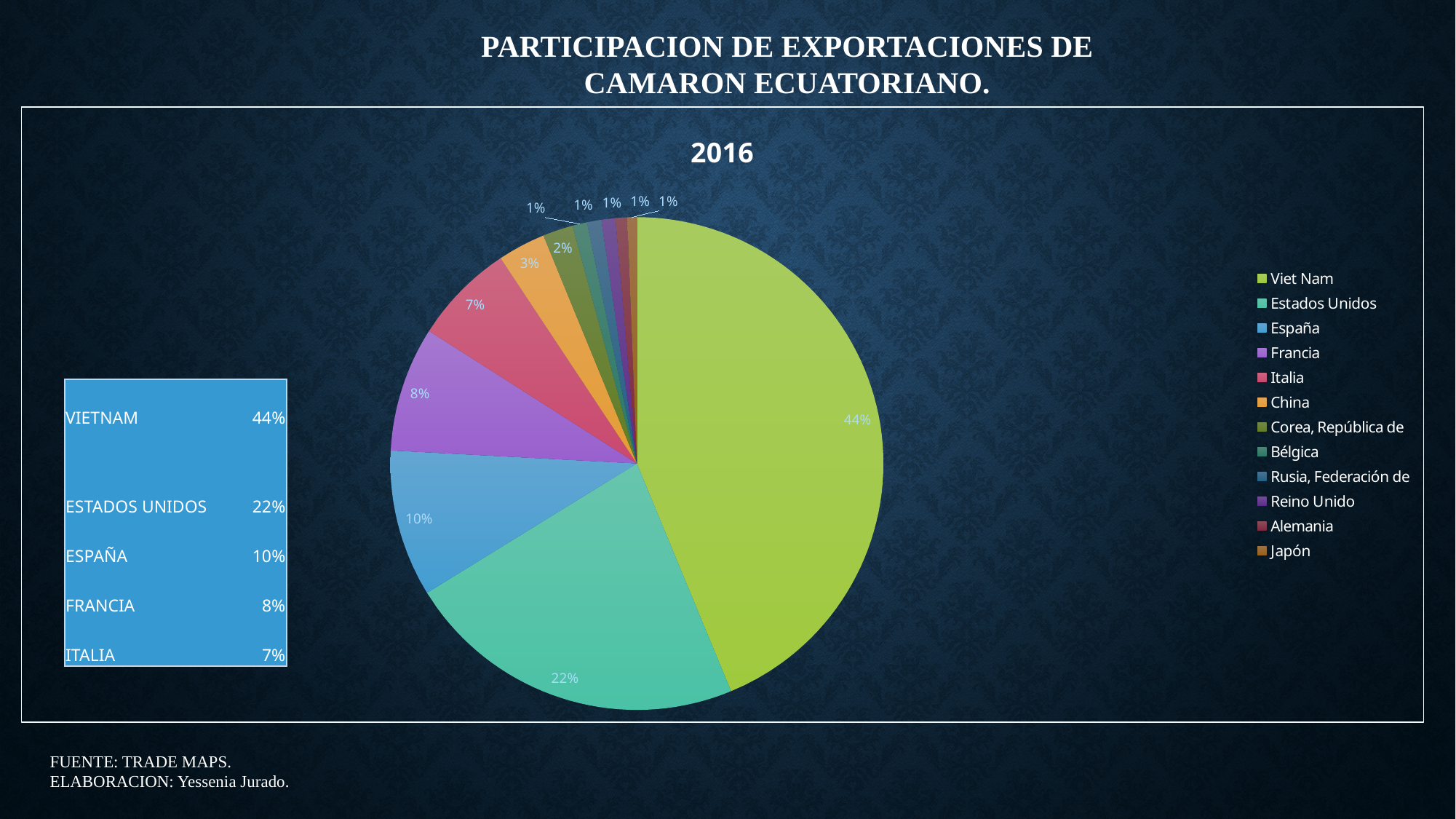
What is the value for Italia? 7% What is the value for China? 3% Which is larger, the share for España or the share for Francia? España How many entries does the legend list? 12 What is the difference between the shares of Viet Nam and Estados Unidos? 22% What is the value for España? 10% Which category has the largest slice of the pie? Viet Nam What is the chart's title? 2016 What share of the pie does Estados Unidos have? 22% What share of the pie does Viet Nam have? 44% What kind of chart is shown on the slide? pie chart What is the value for Francia? 8%